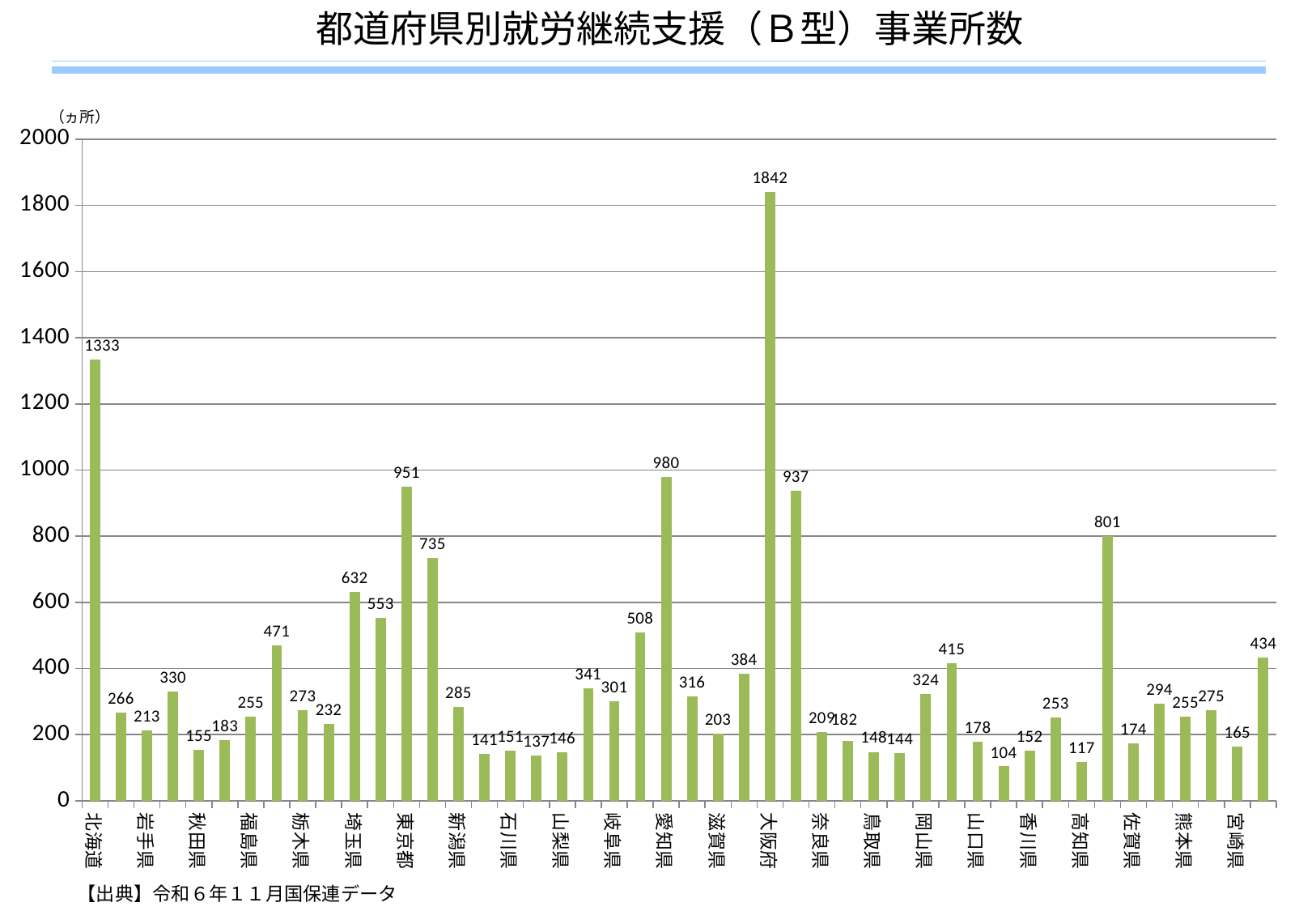
What is the value for 東京都? 951 What is the difference between the values for 愛知県 and 埼玉県? 348 What is the difference between the values for 大阪府 and 東京都? 891 What is the value for 高知県? 117 What is the value for 大阪府? 1842 Which is larger, the value for 北海道 or the value for 愛知県? 北海道 What is the value for 北海道? 1333 What is the title of the chart? 都道府県別就労継続支援（Ｂ型）事業所数 Is the value for 岡山県 greater or less than 200? greater Which prefecture has the highest value? 大阪府 What is the value for 愛知県? 980 What type of chart is shown on the slide? Bar chart